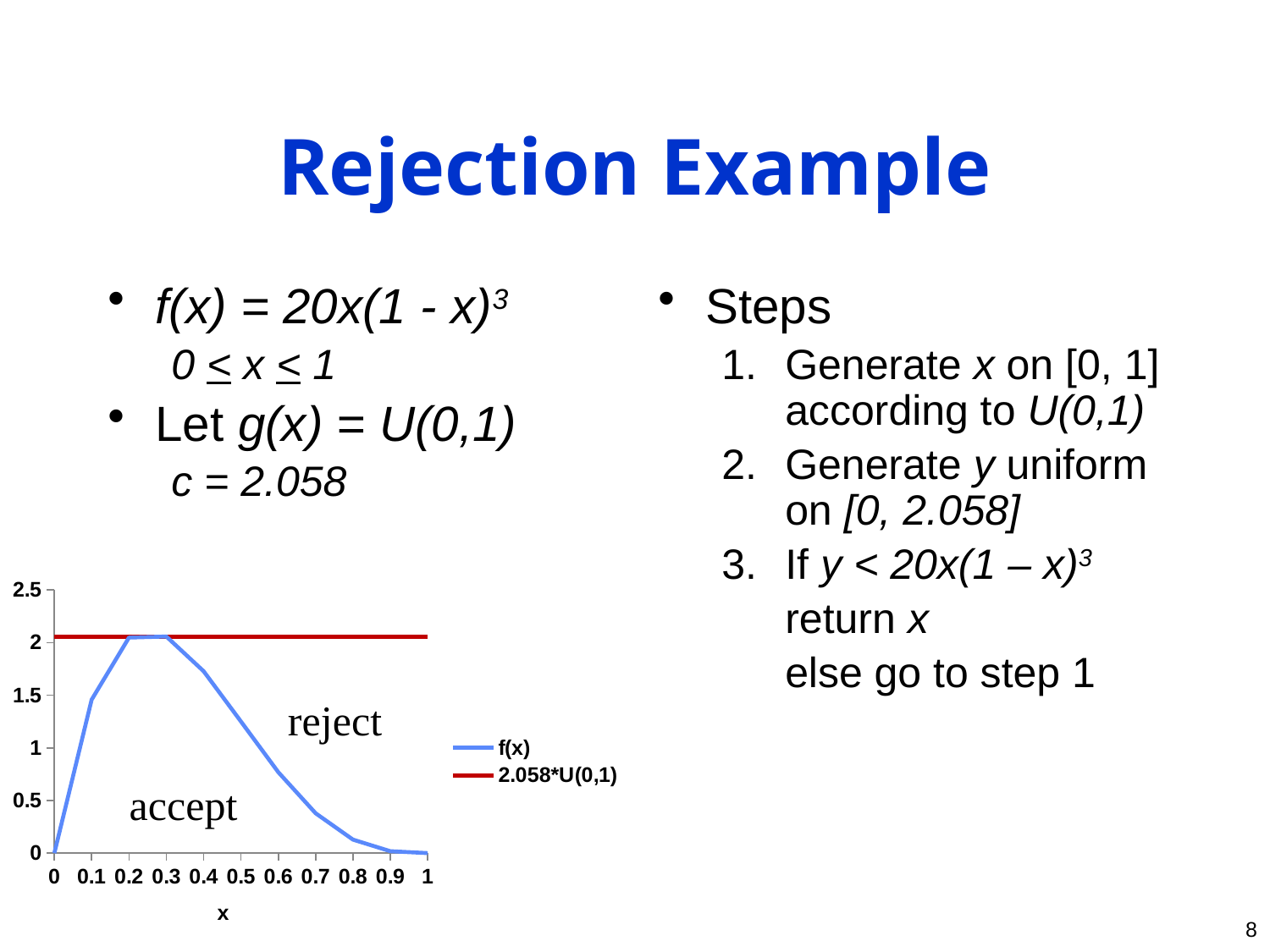
What kind of chart is shown on the slide? line chart What is the value of f(x) at x = 0? 0 How many x-axis tick values are shown on the chart? 11 How many series does the chart legend list? 2 Which is larger, f(x) at x = 0.4 or f(x) at x = 0.7? f(x) at x = 0.4 What are the two series named in the chart legend? f(x) and 2.058*U(0,1) Is the value of f(x) at x = 0.5 greater or less than 1? greater Is the value of f(x) at x = 0.4 greater or less than 2? less What is the label on the x axis of the chart? x Is the value of f(x) at x = 0.7 greater or less than 0.5? less Does f(x) rise or fall as x increases from 0.3 to 1? fall